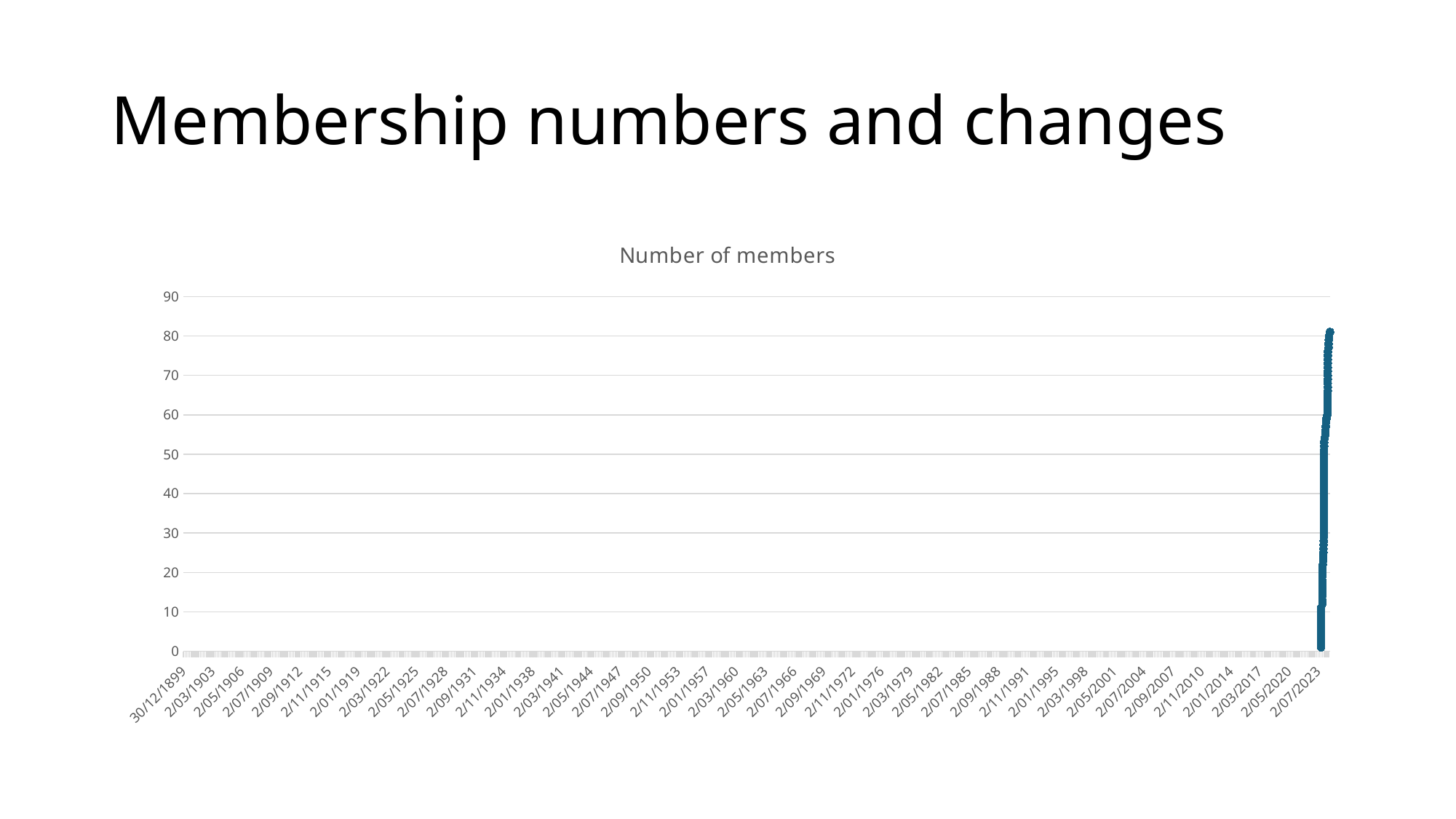
Do the values in the chart rise or fall as the dates move to the right along the x axis? rise What kind of chart is shown on the slide? line chart Is the highest value reached by the line greater or less than 90? less Is the lowest value of the line greater or less than 10? less What is the highest tick value shown on the y axis? 90 What is the title of the chart? Number of members What is the first date label shown on the x axis? 30/12/1899 Is the highest value reached by the line greater or less than 70? greater What is the last date label shown on the x axis? 2/07/2023